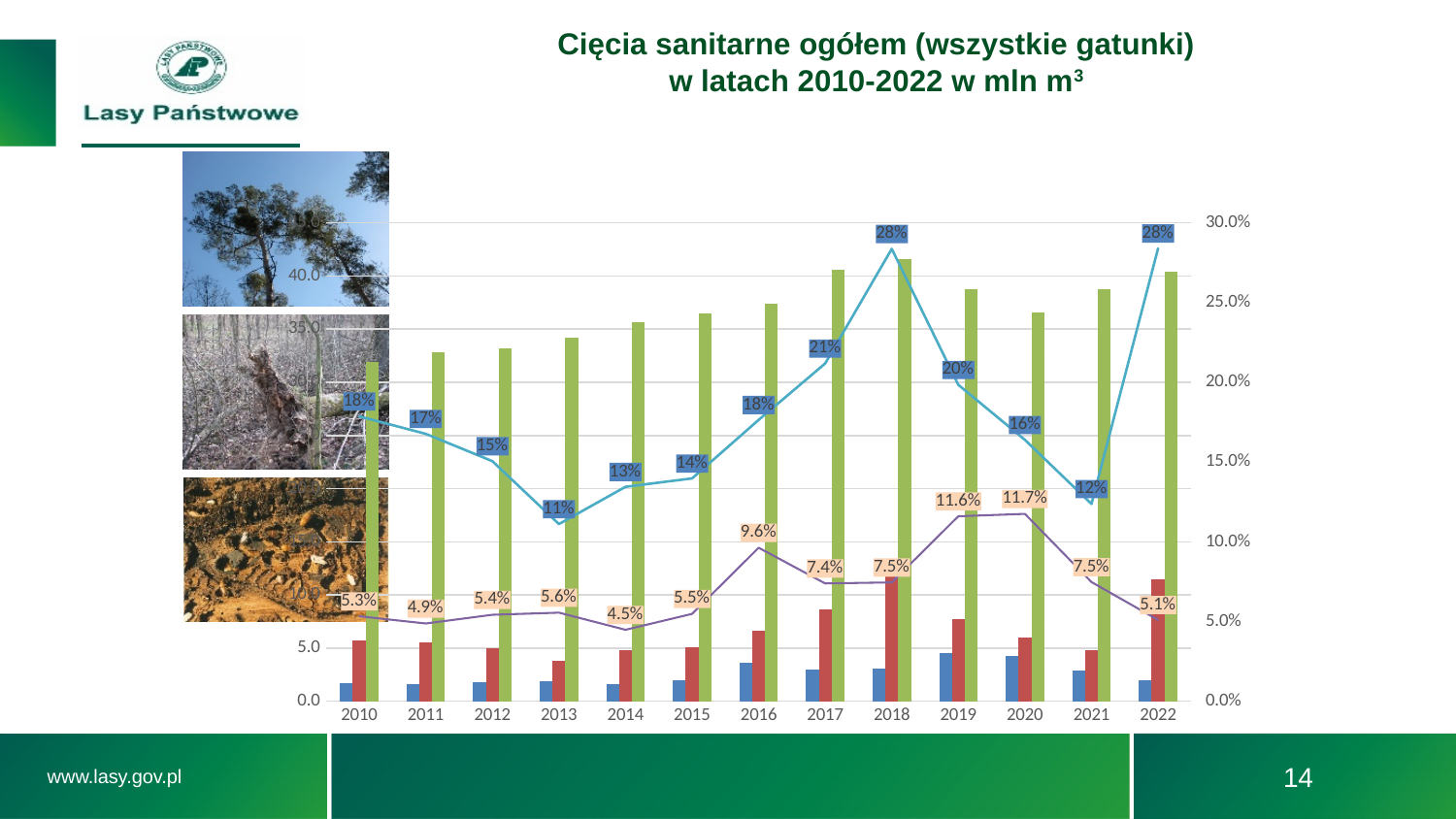
In which year does the upper (blue) line have its lowest labelled value? 2013 What is the value of the lower (purple) line label for 2014? 4.5% What is the value of the upper (blue) line label for 2018? 28% Which year has the larger labelled value on the upper (blue) line, 2017 or 2021? 2017 What is the difference between the lower line's labelled values for 2016 and 2017? 2.2% What is the value of the upper (blue) line label for 2013? 11% How many years are shown on the x axis? 13 In which year does the lower (purple) line reach its highest labelled value? 2020 Does the upper (blue) line rise or fall from 2015 to 2018? Rise What is the value of the lower (purple) line label for 2020? 11.7% What kind of chart is this? Combined bar and line chart What is the difference between the upper line's labelled values for 2018 and 2019? 8%